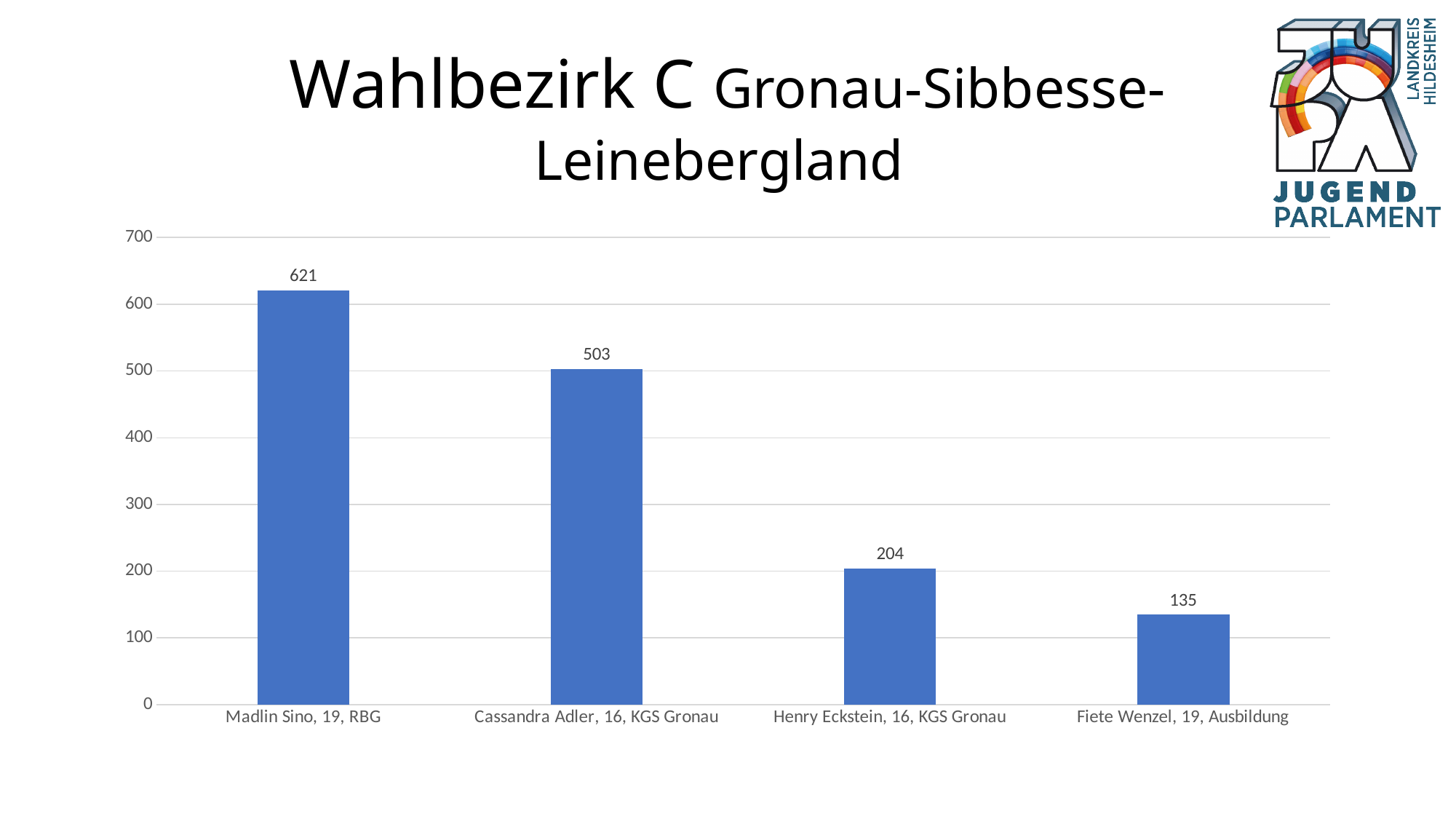
What is the difference between the values for Madlin Sino and Cassandra Adler? 118 What kind of chart is shown on the slide? Bar chart What value is shown for Henry Eckstein, 16, KGS Gronau? 204 Which candidate has the lowest value? Fiete Wenzel, 19, Ausbildung What value is shown for Madlin Sino, 19, RBG? 621 Which candidate has the highest value? Madlin Sino, 19, RBG What value is shown for Fiete Wenzel, 19, Ausbildung? 135 Which is larger, the value for Cassandra Adler or the value for Henry Eckstein? Cassandra Adler How many candidates are shown in the chart? 4 What is the difference between the values for Henry Eckstein and Fiete Wenzel? 69 What value is shown for Cassandra Adler, 16, KGS Gronau? 503 Do the values rise or fall from left to right along the x axis? Fall